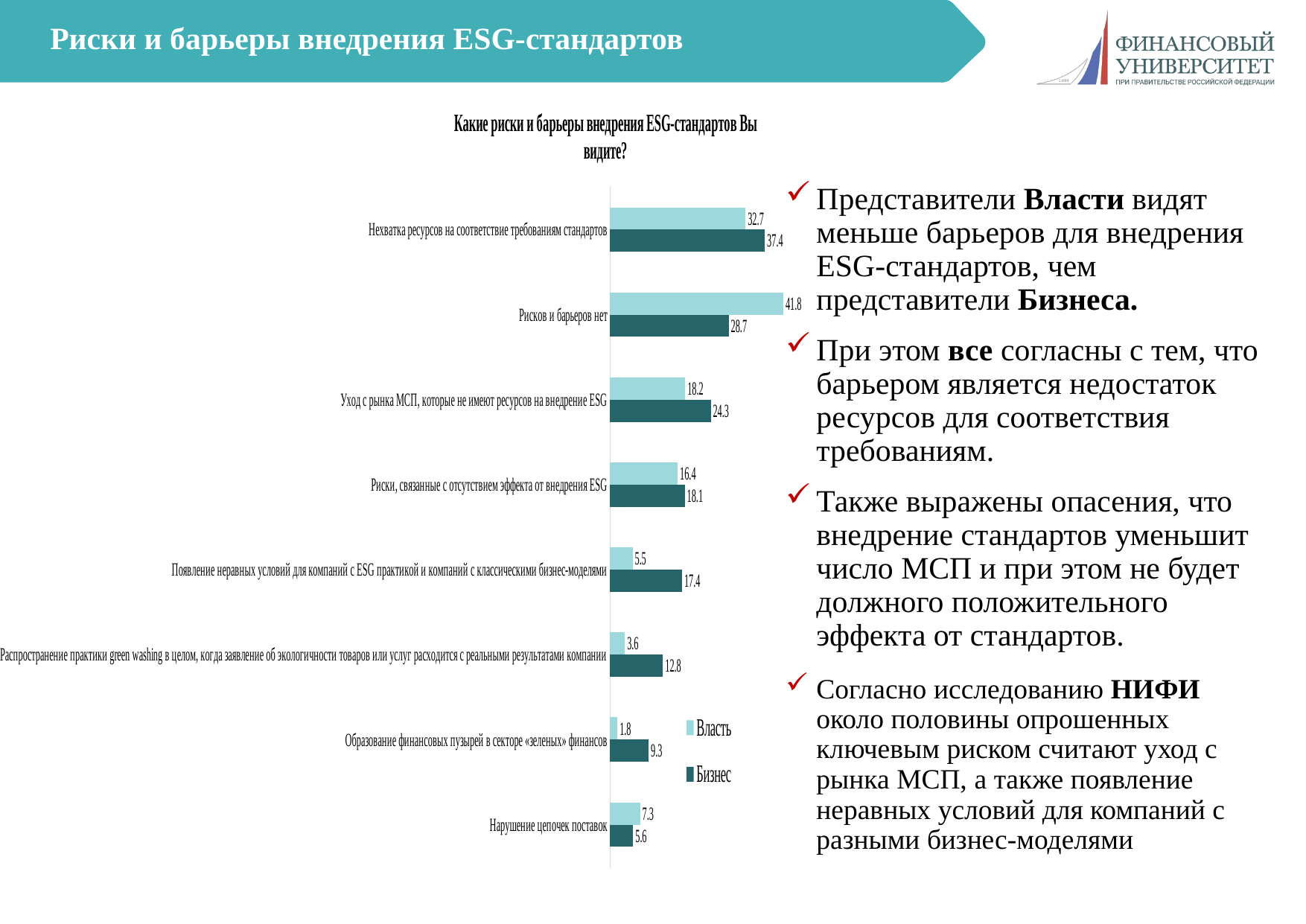
How many series does the chart legend list? 2 For «Нарушение цепочек поставок», which series has the larger value, Власть or Бизнес? Власть What is the value for Бизнес for «Нехватка ресурсов на соответствие требованиям стандартов»? 37.4 How many categories (risks/barriers) are shown in the chart? 8 What type of chart is shown on the slide? bar chart Which series is shown in the darker teal colour in the chart? Бизнес What is the difference between the Власть and Бизнес values for «Рисков и барьеров нет»? 13.1 What is the value for Власть for «Рисков и барьеров нет»? 41.8 Which category has the highest value for the Власть series? Рисков и барьеров нет Which category has the lowest value for the Бизнес series? Нарушение цепочек поставок What is the difference between the Бизнес and Власть values for «Появление неравных условий для компаний с ESG практикой и компаний с классическими бизнес-моделями»? 11.9 What is the value for Бизнес for «Образование финансовых пузырей в секторе «зеленых» финансов»? 9.3